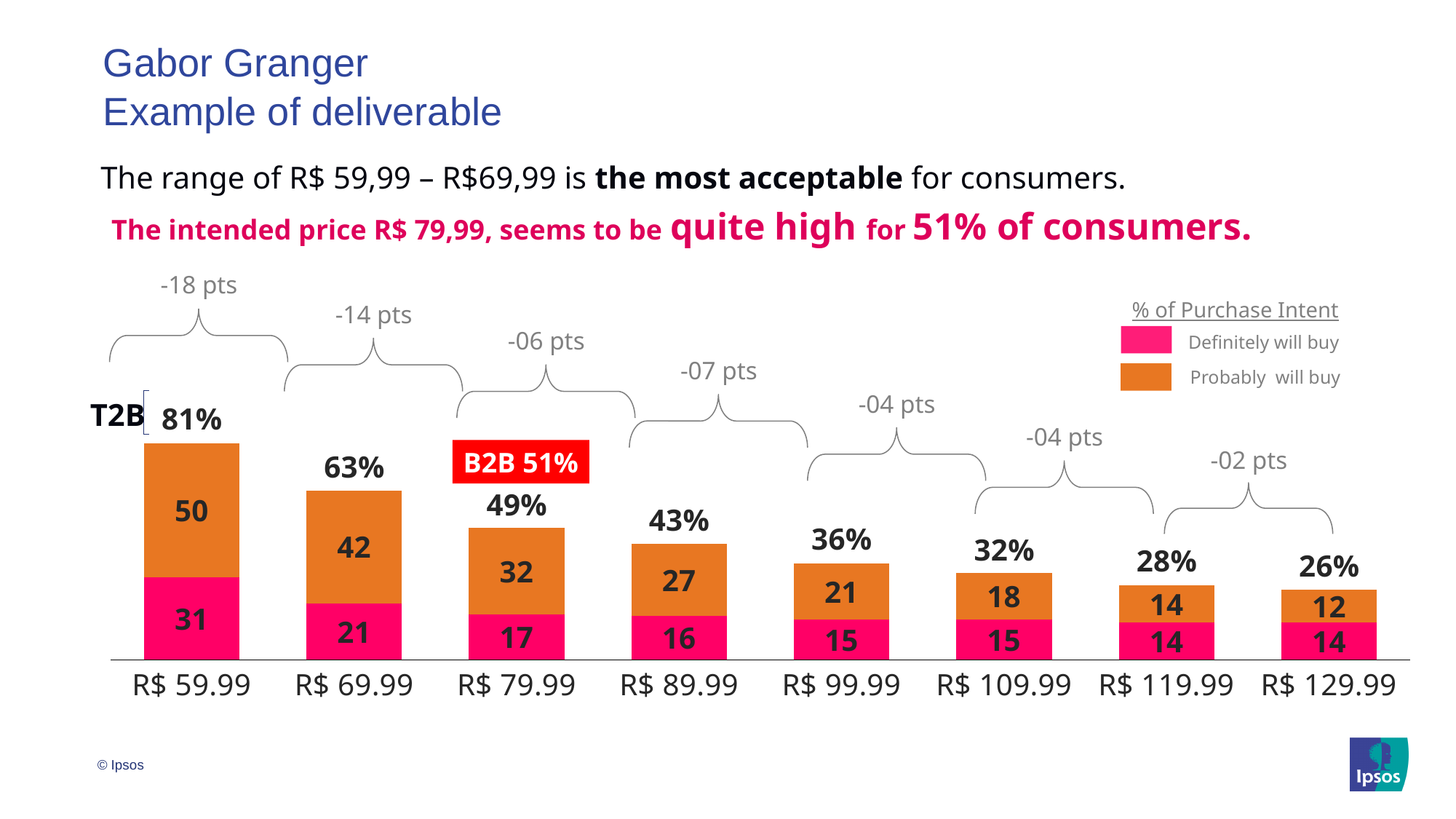
How many series does the legend list? 2 Which price point has the lowest T2B total? R$ 129.99 What is the T2B total shown above the bar for R$ 99.99? 36% Which is larger, the 'Definitely will buy' value for R$ 69.99 or for R$ 79.99? R$ 69.99 What kind of chart is shown on the slide? Stacked bar chart What is the 'Definitely will buy' value for R$ 59.99? 31 Which colour represents 'Definitely will buy' in the legend? Pink How many price points are shown on the x axis? 8 Which price point has the highest T2B total? R$ 59.99 What is the 'Probably will buy' value for R$ 89.99? 27 What is the difference between the 'Probably will buy' values for R$ 59.99 and R$ 69.99? 8 Do the T2B totals rise or fall as the price increases along the x axis? Fall